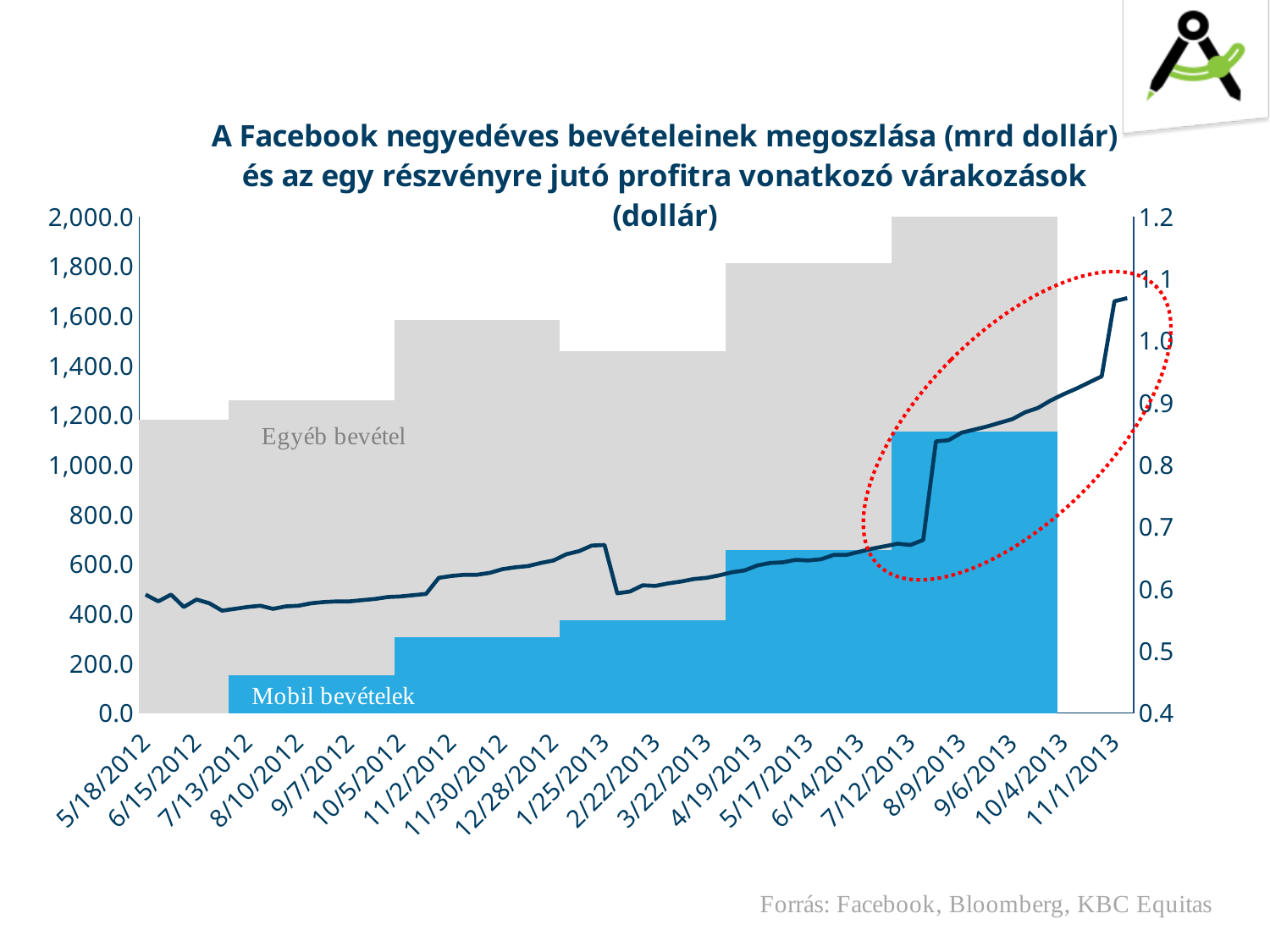
Is the Mobil bevételek value in the final quarter (around 9/6/2013) greater or less than 1,000.0? greater What is the title of the chart? A Facebook negyedéves bevételeinek megoszlása (mrd dollár) és az egy részvényre jutó profitra vonatkozó várakozások (dollár) What is the maximum value shown on the left-hand vertical axis? 2,000.0 Is the value of the line at 11/1/2013 greater or less than 1.0 on the right-hand axis? greater Is the Mobil bevételek value around 10/5/2012 greater or less than 400.0? less How many date labels are shown on the x axis? 20 What type of chart is shown on the slide? Combination of stacked bar chart and line chart Does the line plotted against the right-hand axis generally rise or fall from 5/18/2012 to 11/1/2013? Rise What are the two revenue categories labelled inside the shaded areas of the chart? Egyéb bevétel and Mobil bevételek